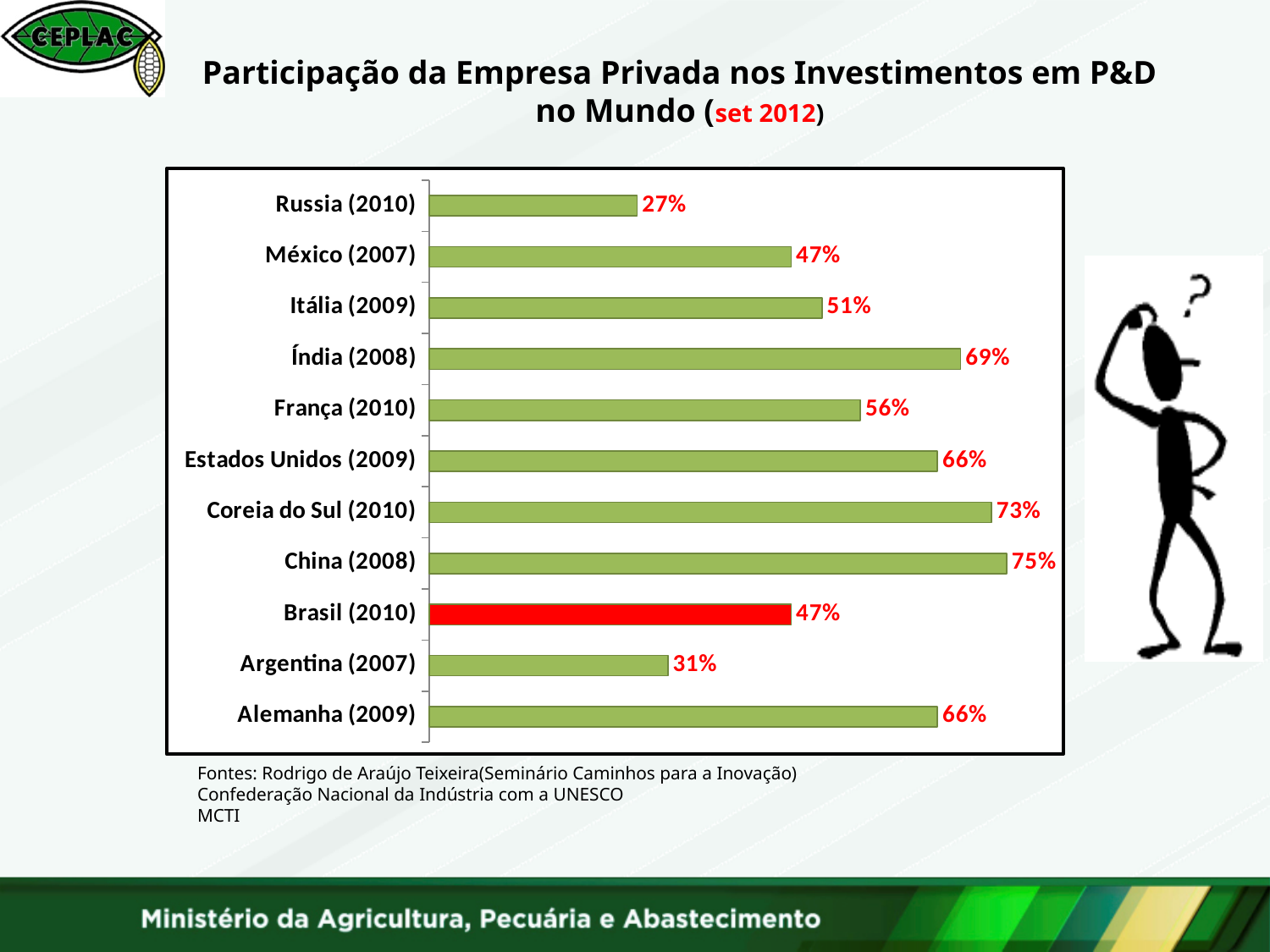
What is the value for Alemanha (2009)? 66% What is the difference between the values for China (2008) and Brasil (2010)? 28% Which category has the highest value? China (2008) How many categories are shown in the chart? 11 Which is larger, the value for Índia (2008) or the value for França (2010)? Índia (2008) Which bar is coloured red instead of green? Brasil (2010) What is the value for Russia (2010)? 27% What kind of chart is shown on the slide? Bar chart What is the difference between the values for Coreia do Sul (2010) and Argentina (2007)? 42% What is the value for China (2008)? 75% What is the value for Brasil (2010)? 47% Which category has the lowest value? Russia (2010)